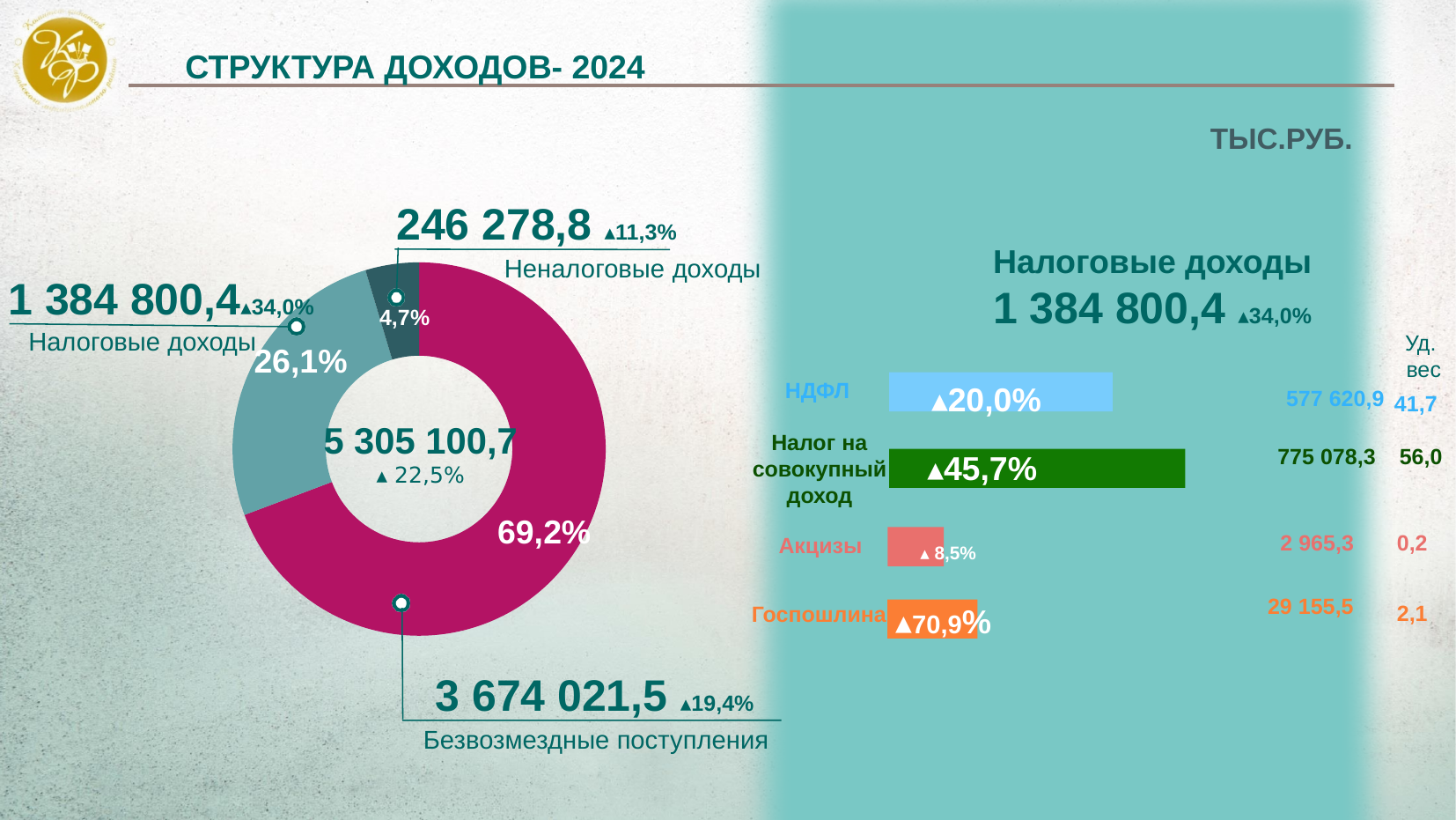
On the donut chart on the left, what total value is shown in the centre? 5 305 100,7 On the Налоговые доходы bar chart on the right, what is the difference between the values for Налог на совокупный доход and НДФЛ? 197 457,4 On the donut chart on the left, what is the value shown for Неналоговые доходы? 246 278,8 On the Налоговые доходы bar chart on the right, what growth percentage is shown on the bar for Налог на совокупный доход? ▲45,7% On the donut chart on the left, what share does Безвозмездные поступления have? 69,2% On the Налоговые доходы bar chart on the right, what value is shown for НДФЛ? 577 620,9 On the donut chart on the left, which category has the largest share? Безвозмездные поступления How many slices does the donut chart on the left have? 3 On the donut chart on the left, which category has the smallest share? Неналоговые доходы On the Налоговые доходы bar chart on the right, which category has the highest growth percentage? Госпошлина What kind of chart is shown on the left of the slide? Donut (pie) chart On the donut chart on the left, what is the value shown for Налоговые доходы? 1 384 800,4